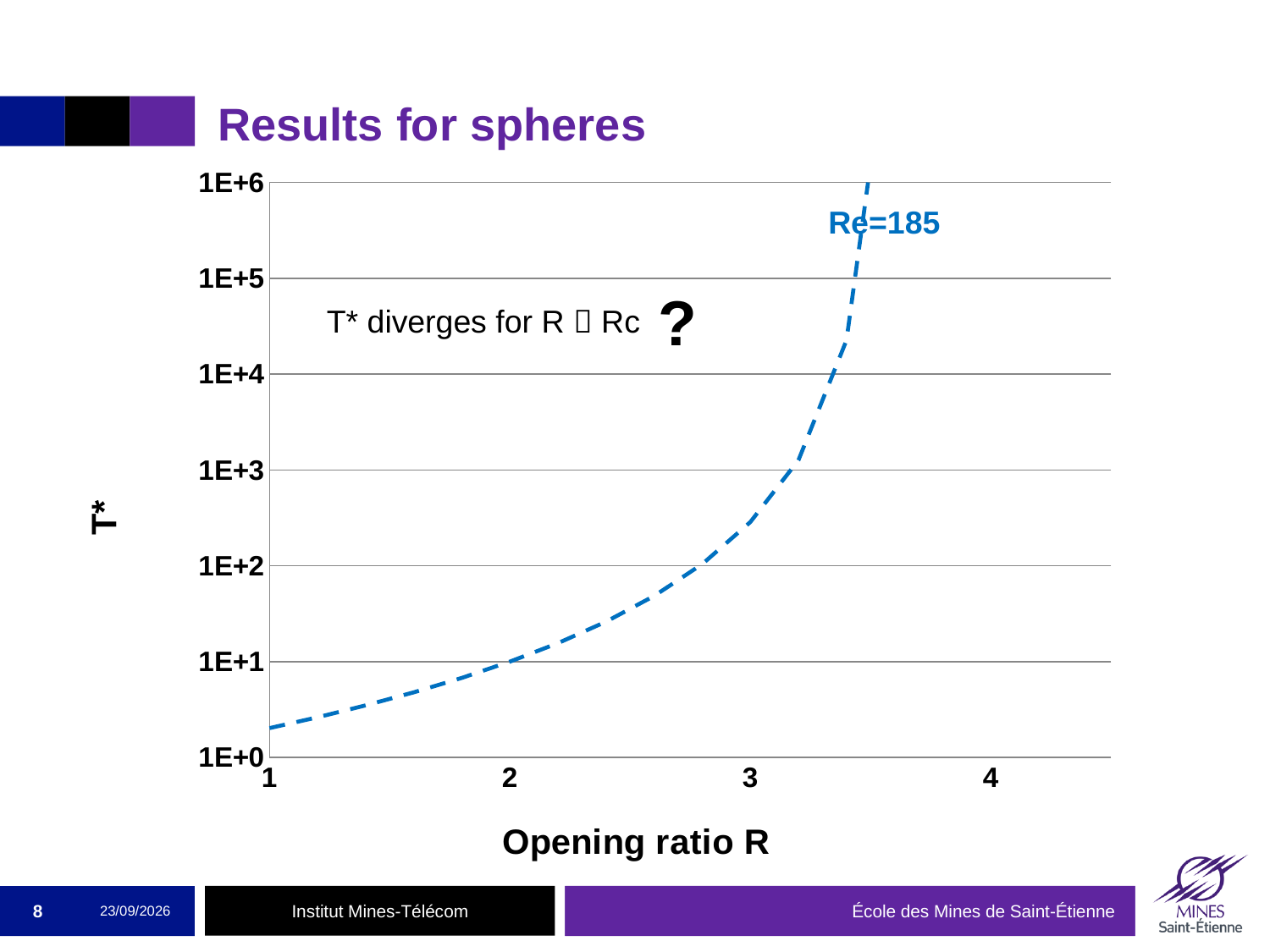
What is the title of the chart on the slide? Results for spheres Which has the larger T* value, opening ratio R = 2 or R = 3? R = 3 Is the value of T* at opening ratio R = 2.5 greater or less than 1E+3? less Is the value of T* at opening ratio R = 3 greater or less than 1E+2? greater Is the value of T* at opening ratio R = 3 greater or less than 1E+4? less What kind of chart is shown on the slide? line chart Does T* rise or fall as the opening ratio R increases? rise What Reynolds number is annotated on the chart? Re=185 How many labelled tick values are shown on the x axis (Opening ratio R)? 4